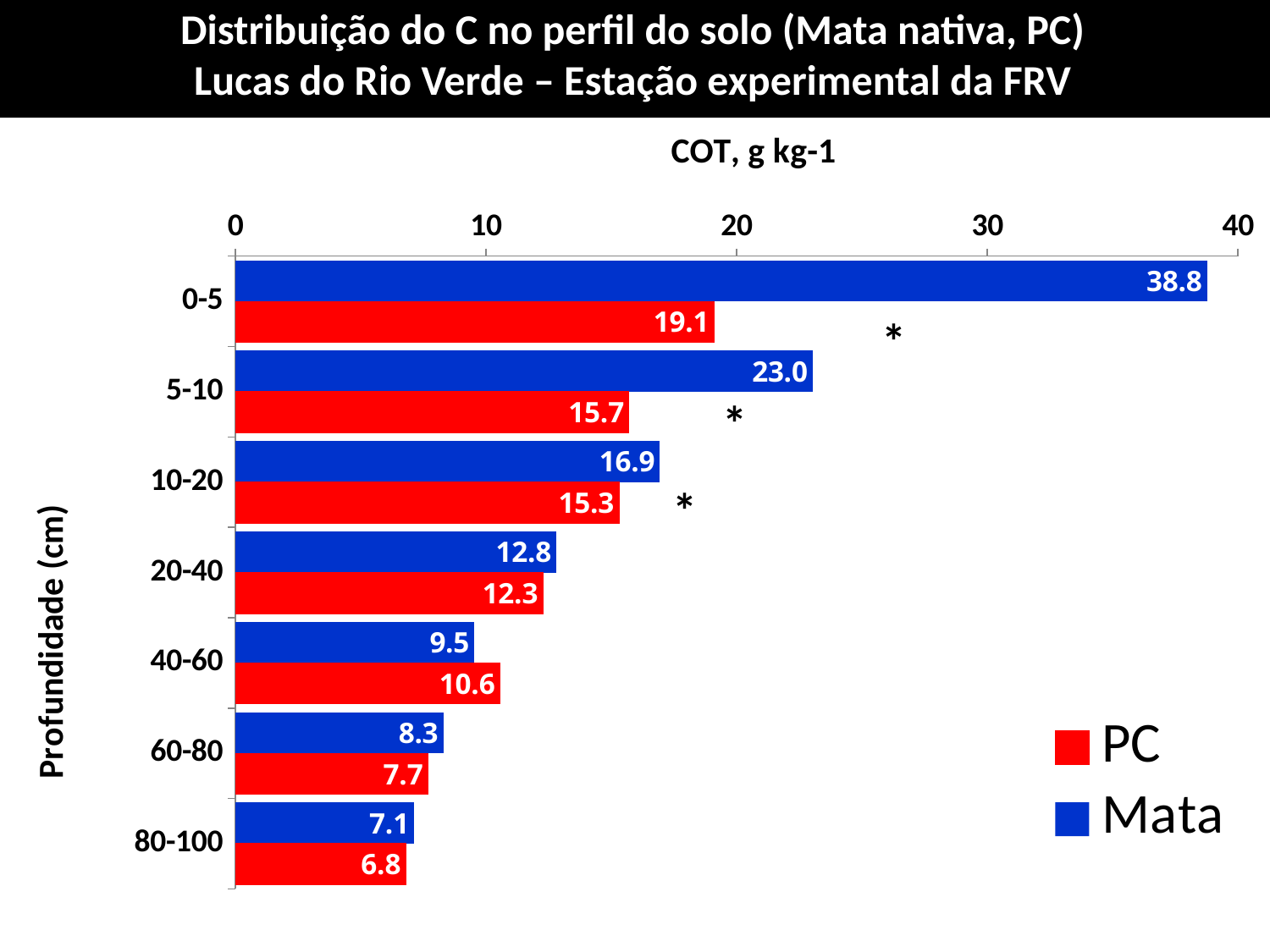
What is the difference between the Mata and PC values at the 0-5 cm depth? 19.7 Which depth has the highest COT value for Mata? 0-5 At the 40-60 cm depth, which series has the larger COT value, PC or Mata? PC What kind of chart is shown on the slide? bar chart Which depth has the lowest COT value for PC? 80-100 What is the COT value for PC at the 40-60 cm depth? 10.6 How many depth categories are shown on the chart? 7 How many series does the legend list? 2 What is the COT value for PC at the 5-10 cm depth? 15.7 What is the label of the horizontal axis? COT, g kg-1 What is the COT value for Mata at the 0-5 cm depth? 38.8 Is the Mata value at the 5-10 cm depth greater or less than 20? greater